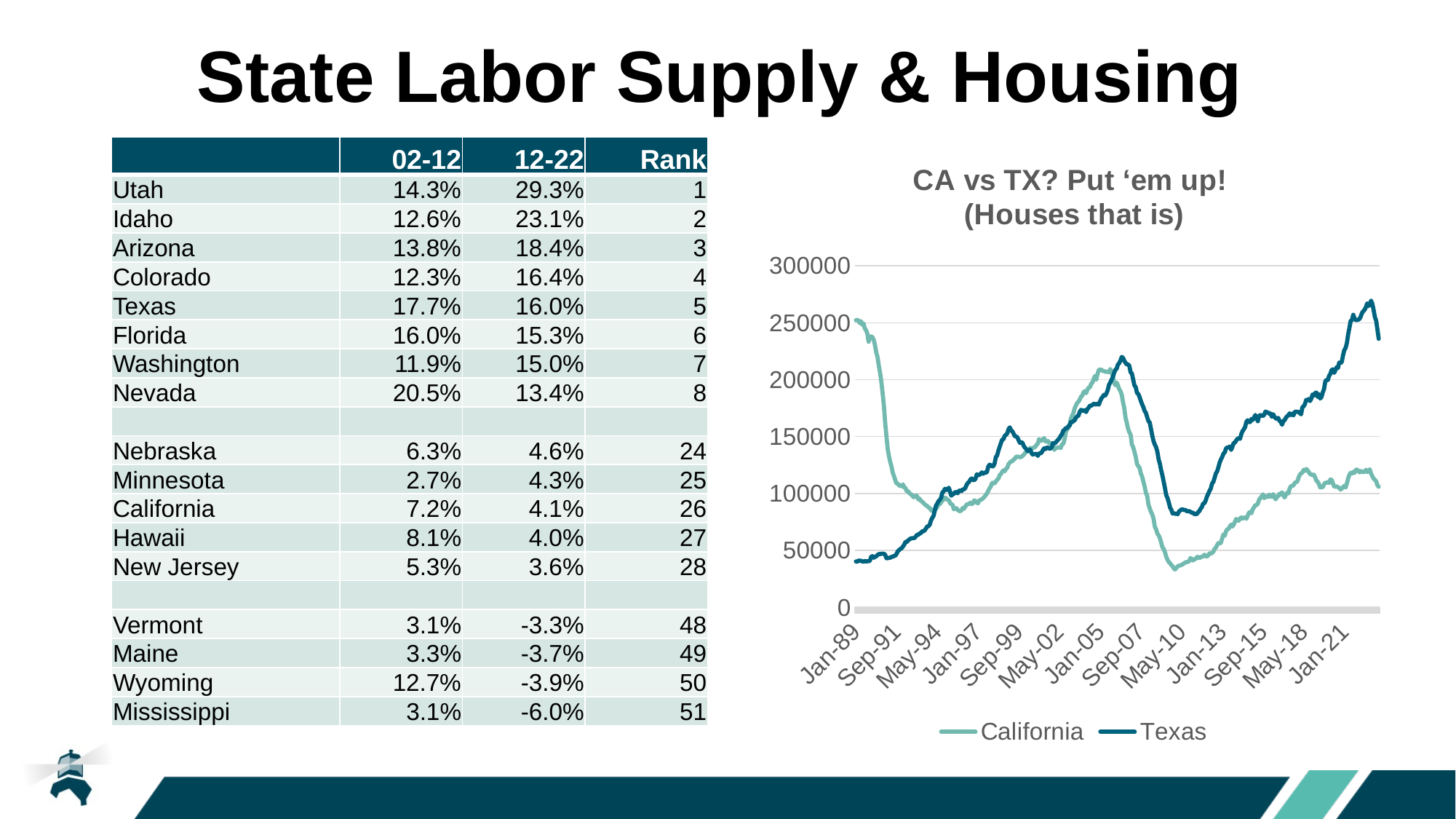
In the line chart, is the value for Texas at Jan-21 greater or less than 200000? greater In the line chart, is the value for California at Jan-89 greater or less than 200000? greater In the line chart, which series has the higher value at Jan-89, California or Texas? California What kind of chart is shown on the right side of the slide? line chart In the line chart, does the Texas series generally rise or fall between May-10 and Jan-21? rise In the line chart, is the value for Texas at Jan-89 greater or less than 100000? less What is the title of the line chart on the slide? CA vs TX? Put 'em up! (Houses that is) In the line chart, which series has the higher value at Jan-21, California or Texas? Texas Which two series are listed in the legend of the line chart? California and Texas How many series does the legend of the 'CA vs TX? Put 'em up!' chart list? 2